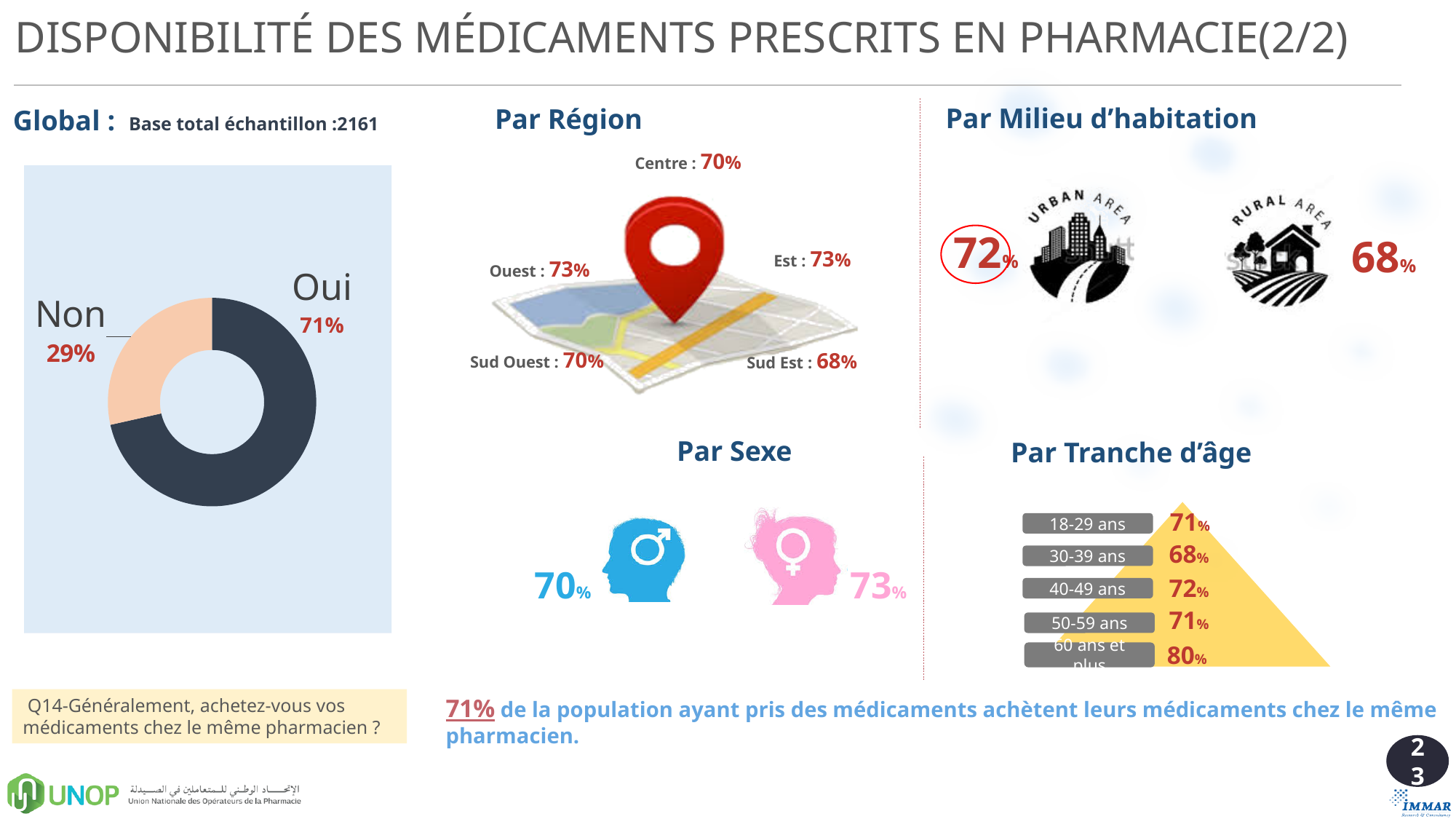
In the Global donut chart, what percentage is shown for "Non"? 29% In the "Par Milieu d'habitation" panel, what value is shown for the urban area? 72% In the Global donut chart, which slice is larger, "Oui" or "Non"? Oui In the "Par Sexe" panel, which value is higher, men or women? Women (73%) In the "Par Région" panel, which region has the lowest value? Sud Est What kind of chart is shown in the Global panel on the left? Donut (pie) chart What is the base total sample size stated for the Global chart? 2161 How many slices does the Global donut chart have? 2 In the Global donut chart, what percentage is shown for "Oui"? 71% In the "Par Région" panel, what value is shown for Sud Est? 68% In the Global donut chart, what is the difference between the "Oui" and "Non" shares? 42 percentage points In the "Par Tranche d'âge" panel, which age group has the highest value? 60 ans et plus